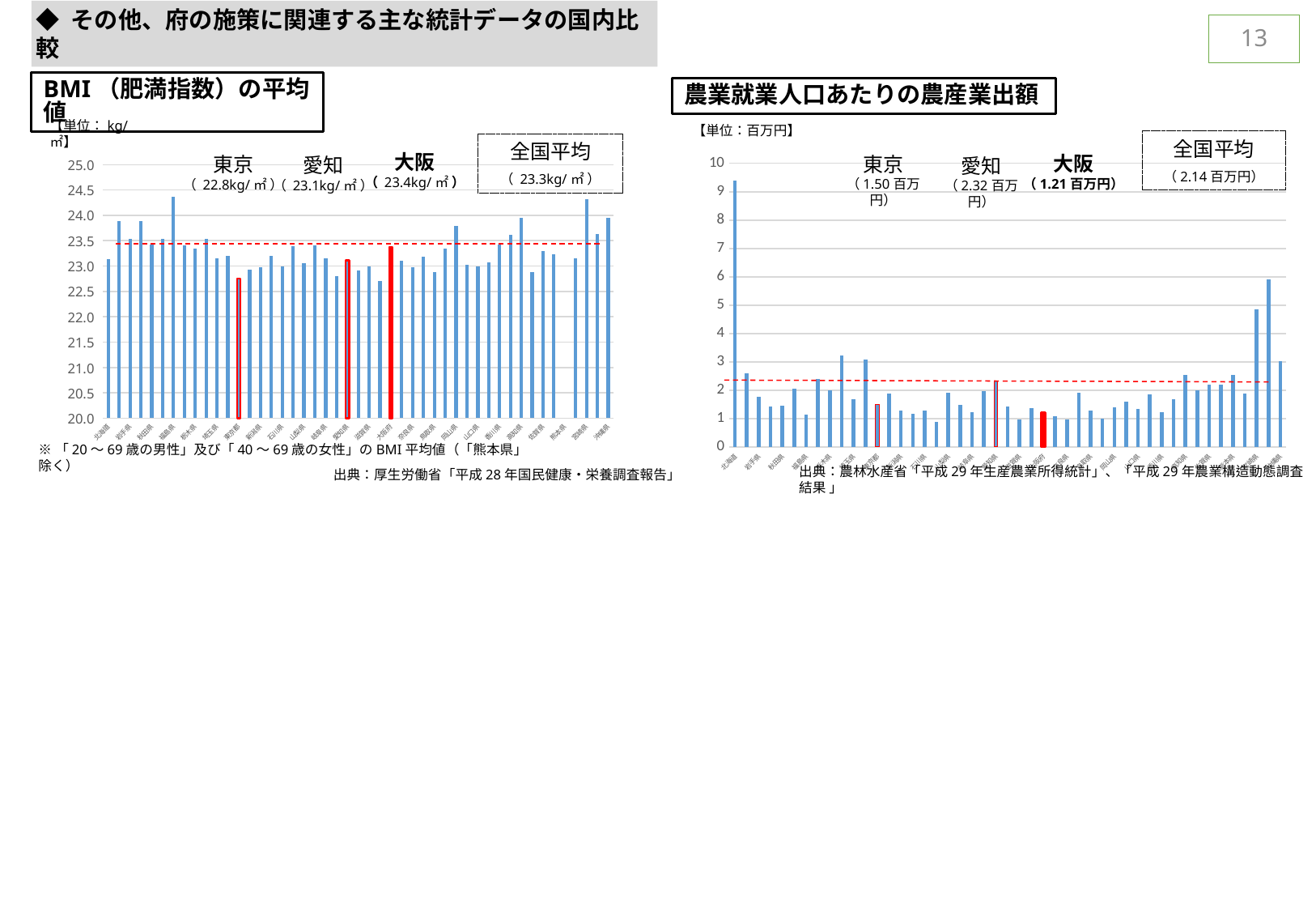
In the 農業就業人口あたりの農産業出額 chart, is the value of the tallest bar greater or less than 8? greater In the BMI（肥満指数）の平均値 chart, what is the BMI value shown for 大阪? 23.4kg/㎡ In the BMI（肥満指数）の平均値 chart, which has the higher BMI value, 大阪 or 東京? 大阪 In the 農業就業人口あたりの農産業出額 chart, what is the value shown for 大阪? 1.21百万円 In the BMI（肥満指数）の平均値 chart, what is the 全国平均 (national average) value? 23.3kg/㎡ In the 農業就業人口あたりの農産業出額 chart, which has the larger value, 愛知 or 大阪? 愛知 In the 農業就業人口あたりの農産業出額 chart, what is the difference between the values for 愛知 and 大阪? 1.11百万円 In the 農業就業人口あたりの農産業出額 chart, what is the value shown for 愛知? 2.32百万円 In the BMI（肥満指数）の平均値 chart, what is the BMI value shown for 東京? 22.8kg/㎡ What kind of chart is the BMI（肥満指数）の平均値 chart on the left? bar chart In the 農業就業人口あたりの農産業出額 chart, what is the 全国平均 (national average) value? 2.14百万円 In the BMI（肥満指数）の平均値 chart, what is the difference between the BMI values for 大阪 and 東京? 0.6kg/㎡